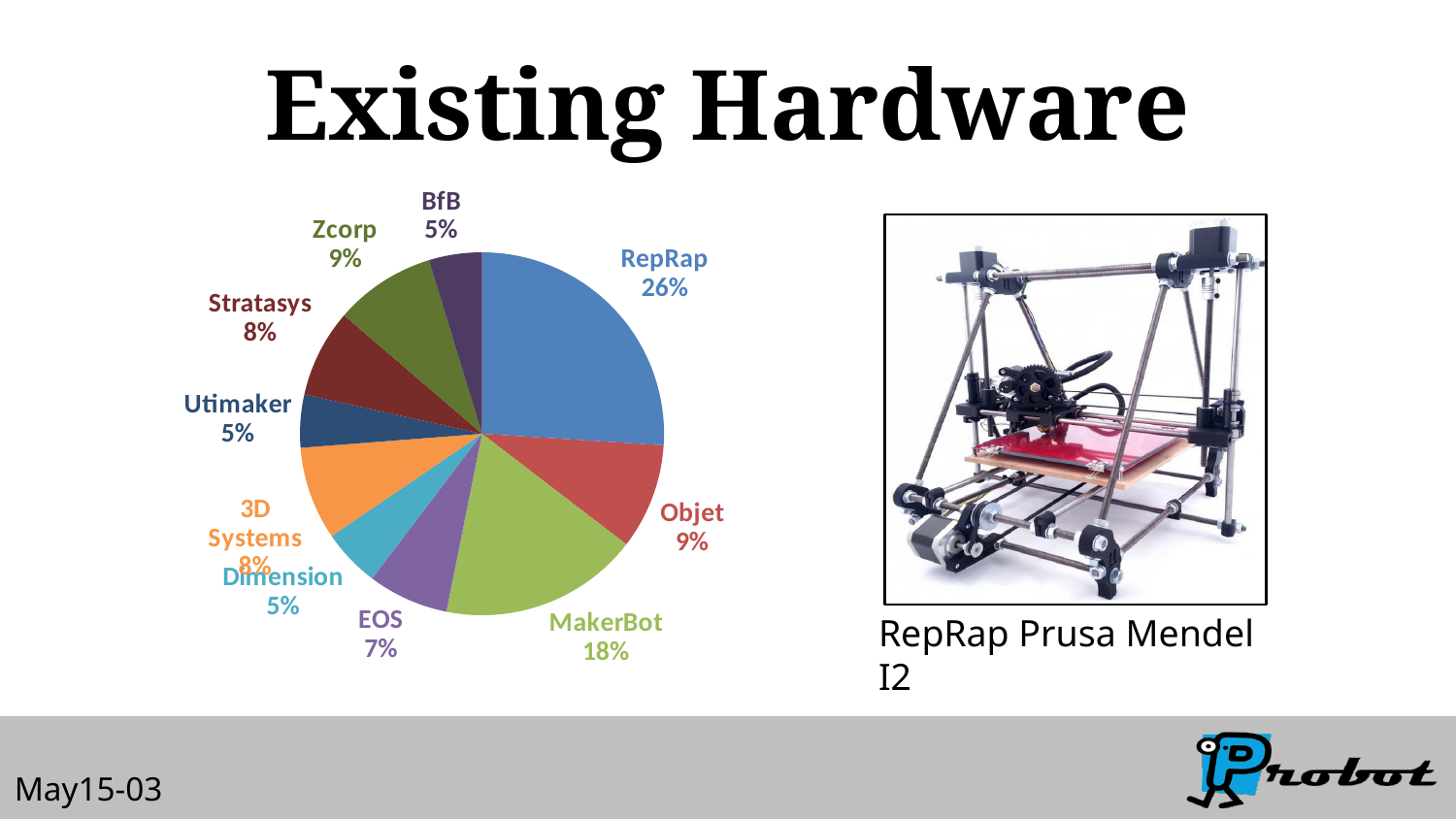
What is the title of the slide containing the pie chart? Existing Hardware What is the difference in percentage points between RepRap and MakerBot in the pie chart? 8 Which category has the largest slice in the pie chart? RepRap How many categories are shown in the pie chart? 10 What percentage is shown for Stratasys in the pie chart? 8% What percentage is shown for EOS in the pie chart? 7% What share of the pie chart does RepRap hold? 26% Which is larger in the pie chart, Objet or EOS? Objet What is the combined percentage of Zcorp and BfB in the pie chart? 14% Which is larger in the pie chart, Zcorp or Dimension? Zcorp What percentage is shown for MakerBot in the pie chart? 18% What kind of chart is shown on the slide? Pie chart